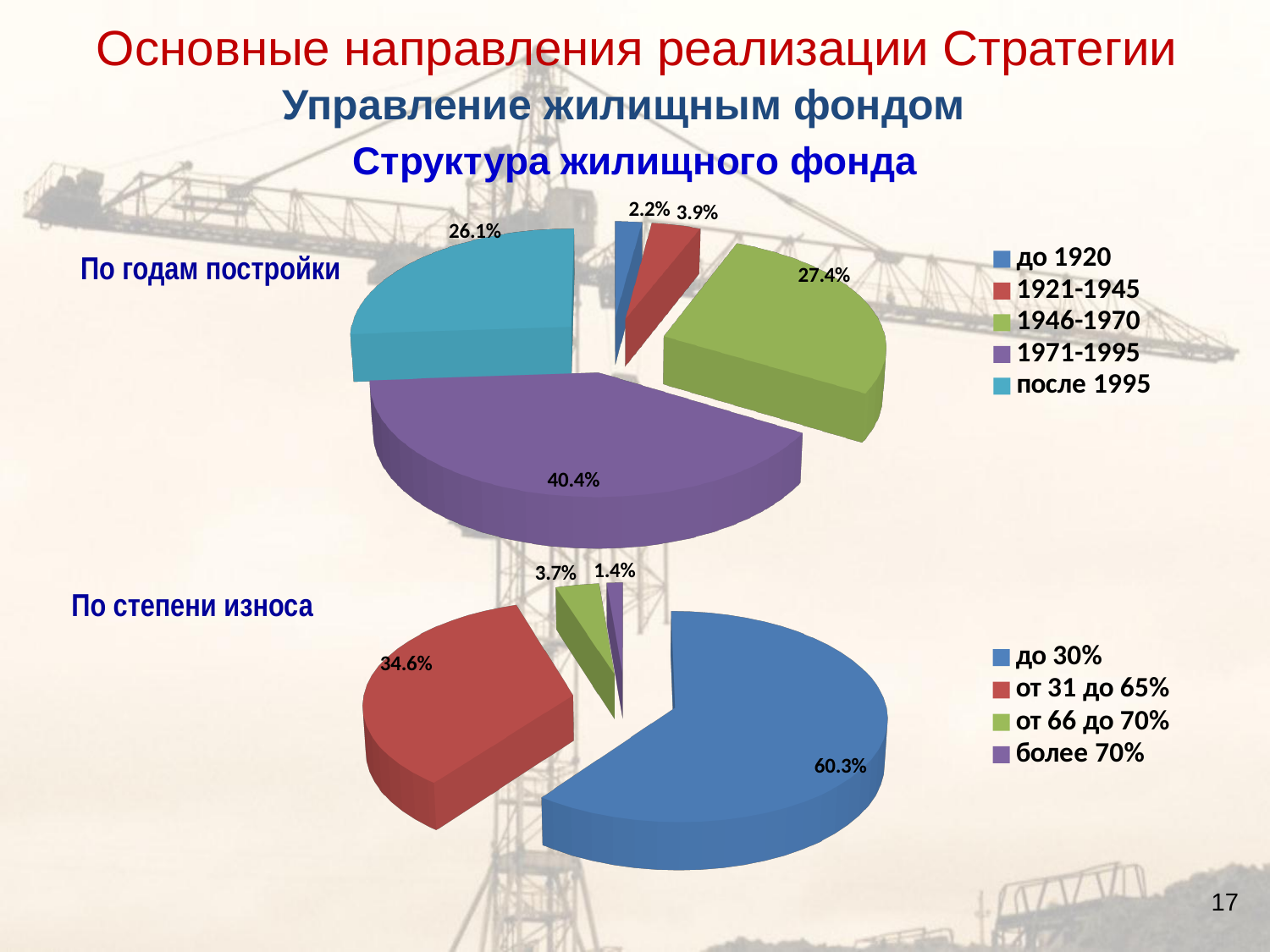
In the bottom pie chart (По степени износа), which category has the smallest share? более 70% In the top pie chart (По годам постройки), what is the difference between the 1946-1970 share and the после 1995 share? 1.3% In the top pie chart (По годам постройки), which period has the smallest share? до 1920 In the bottom pie chart (По степени износа), what share of the housing stock has wear of до 30%? 60.3% In the bottom pie chart (По степени износа), what is the difference between the до 30% share and the от 31 до 65% share? 25.7% In the top pie chart (По годам постройки), how many categories does the legend list? 5 In the top pie chart (По годам постройки), what share of the housing stock was built in 1971-1995? 40.4% In the top pie chart (По годам постройки), which period has the largest share? 1971-1995 What type of chart is used for both charts on the slide? Pie chart In the bottom pie chart (По степени износа), what share has wear of от 66 до 70%? 3.7% In the bottom pie chart (По степени износа), which is larger: the share for до 30% or the share for от 31 до 65%? до 30% In the top pie chart (По годам постройки), what share was built after 1995 (после 1995)? 26.1%